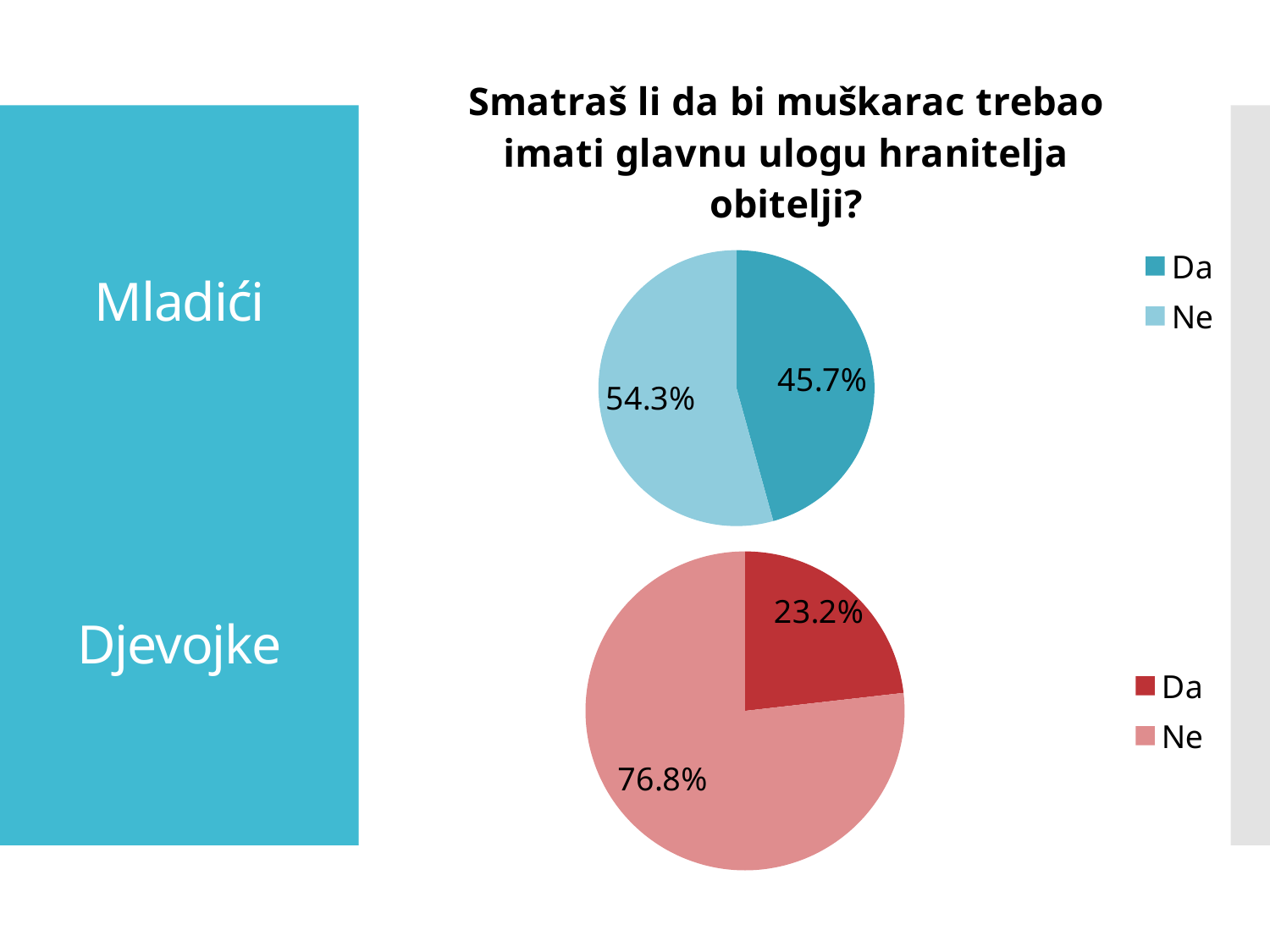
In the bottom pie chart (Djevojke), what is the difference between the "Ne" and "Da" shares? 53.6% How many slices does the top pie chart (Mladići) have? 2 In the top pie chart (Mladići), what share of respondents answered "Da"? 45.7% In the bottom pie chart (Djevojke), what share of respondents answered "Da"? 23.2% How many entries does the legend of the bottom pie chart (Djevojke) list? 2 In the bottom pie chart (Djevojke), which answer has the smaller slice? Da In the bottom pie chart (Djevojke), what share of respondents answered "Ne"? 76.8% In the top pie chart (Mladići), which answer has the larger slice? Ne What type of chart is used on this slide? Pie chart Is the "Da" share larger in the top pie chart (Mladići) or in the bottom pie chart (Djevojke)? Mladići What is the title shown above the pie charts? Smatraš li da bi muškarac trebao imati glavnu ulogu hranitelja obitelji? In the top pie chart (Mladići), what share of respondents answered "Ne"? 54.3%